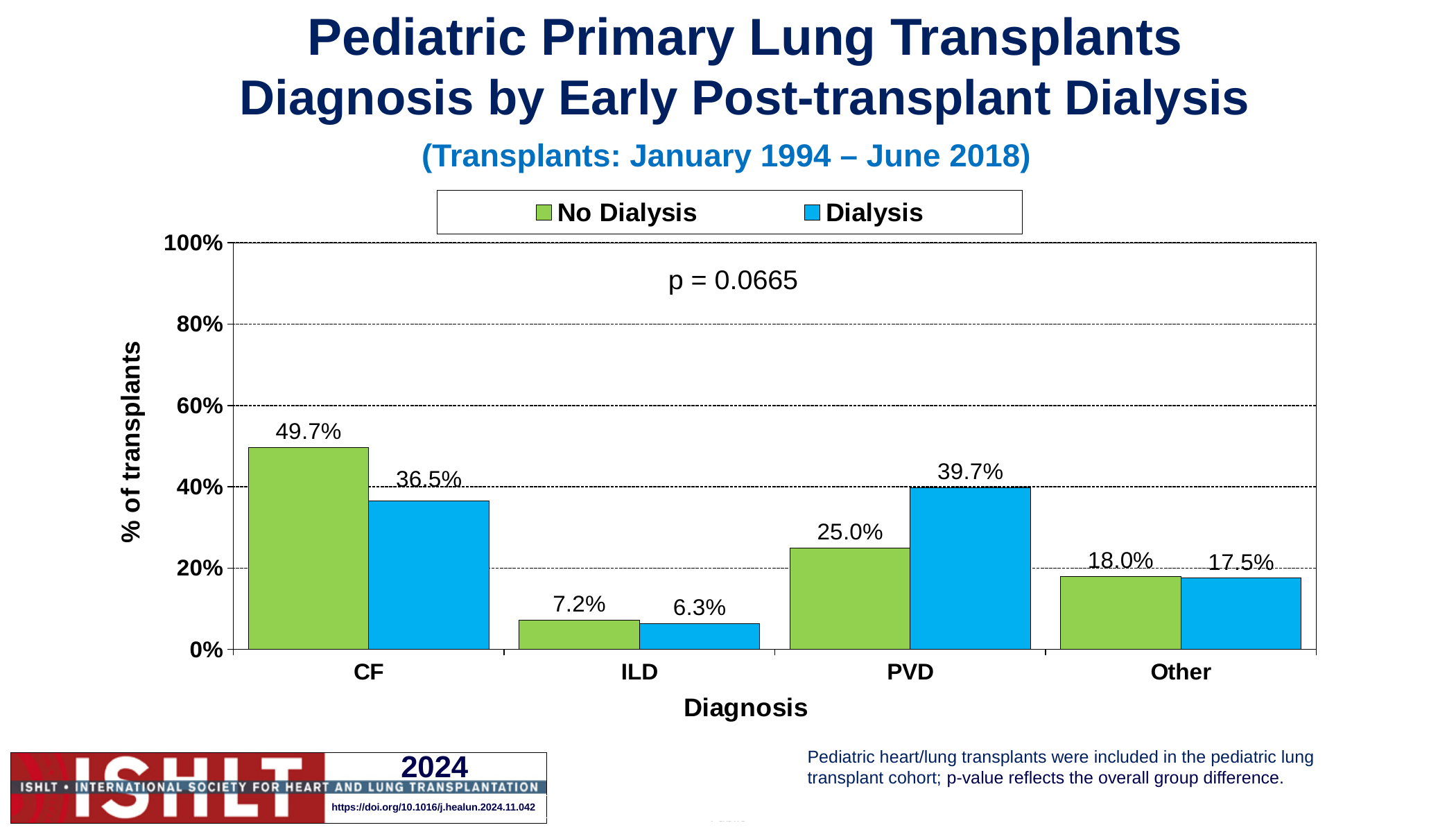
What is the Dialysis value for PVD? 39.7% How many series does the legend list? 2 What is the difference between the Dialysis and No Dialysis values for PVD? 14.7% Which diagnosis has the highest No Dialysis value? CF Is the No Dialysis value for CF greater or less than 40%? greater What is the difference between the No Dialysis and Dialysis values for CF? 13.2% What is the No Dialysis value for CF? 49.7% What is the Dialysis value for ILD? 6.3% What kind of chart is shown on the slide? Bar chart Which diagnosis has the lowest Dialysis value? ILD For PVD, which is larger: the No Dialysis value or the Dialysis value? Dialysis How many diagnosis categories are shown on the x axis? 4